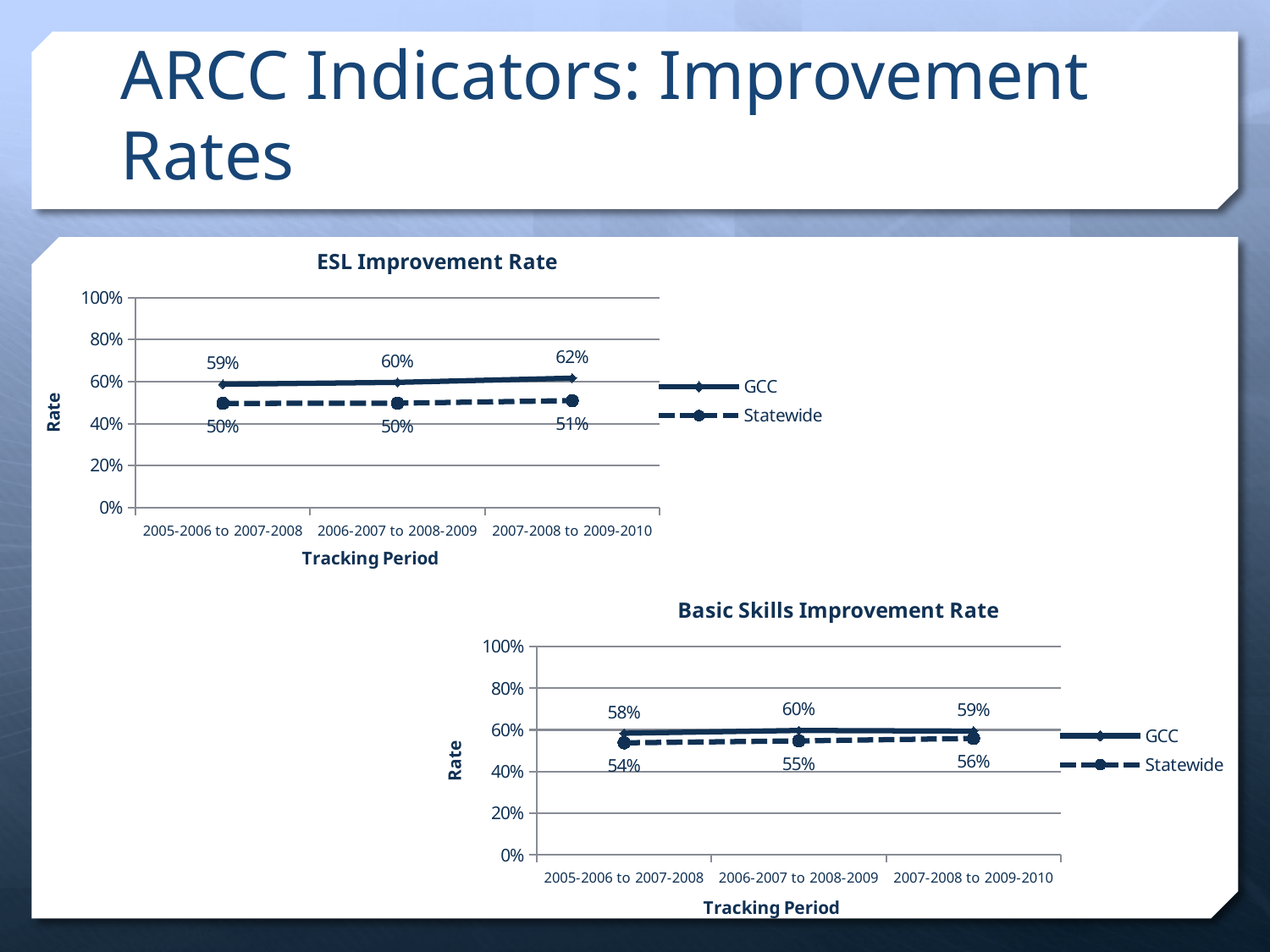
In the Basic Skills Improvement Rate chart, which is larger for 2005-2006 to 2007-2008, the GCC value or the Statewide value? GCC In the Basic Skills Improvement Rate chart, how many tracking periods are shown on the x axis? 3 In the Basic Skills Improvement Rate chart, which tracking period has the lowest Statewide value? 2005-2006 to 2007-2008 In the ESL Improvement Rate chart, what is the GCC value for 2007-2008 to 2009-2010? 62% In the ESL Improvement Rate chart, what is the Statewide value for 2005-2006 to 2007-2008? 50% In the ESL Improvement Rate chart, what is the difference between the GCC and Statewide values for 2007-2008 to 2009-2010? 11% In the ESL Improvement Rate chart, which tracking period has the highest GCC value? 2007-2008 to 2009-2010 In the Basic Skills Improvement Rate chart, what is the Statewide value for 2007-2008 to 2009-2010? 56% In the ESL Improvement Rate chart, does the GCC line rise or fall across the tracking periods? rise What kind of chart is the Basic Skills Improvement Rate chart? line chart In the ESL Improvement Rate chart, how many series does the legend list? 2 In the Basic Skills Improvement Rate chart, what is the GCC value for 2006-2007 to 2008-2009? 60%